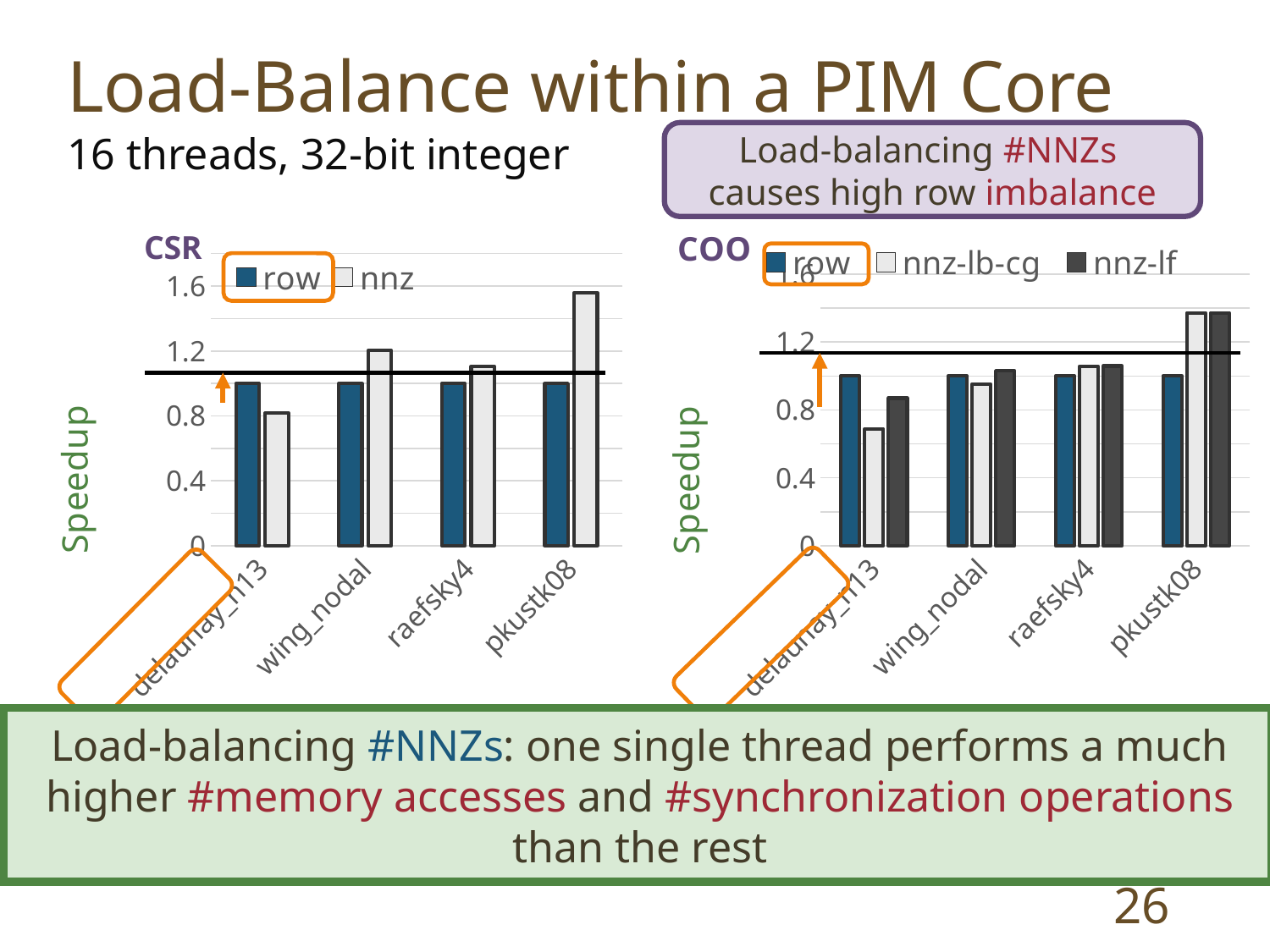
In the COO chart, is the nnz-lb-cg value for delaunay_n13 greater or less than 0.8? less What type of chart is the CSR chart on the left? bar chart In the COO chart, is the nnz-lb-cg value for pkustk08 greater or less than 1.2? greater In the CSR chart, which category has the lowest nnz bar? delaunay_n13 In the CSR chart, is the nnz value for pkustk08 greater or less than 1.2? greater How many series does the legend of the COO chart on the right list? 3 In the CSR chart, which category has the highest nnz bar? pkustk08 In the COO chart, for delaunay_n13, which is larger: nnz-lb-cg or nnz-lf? nnz-lf What is the label on the y axis of the COO chart? Speedup How many series does the legend of the CSR chart on the left list? 2 How many categories are shown on the x axis of the CSR chart? 4